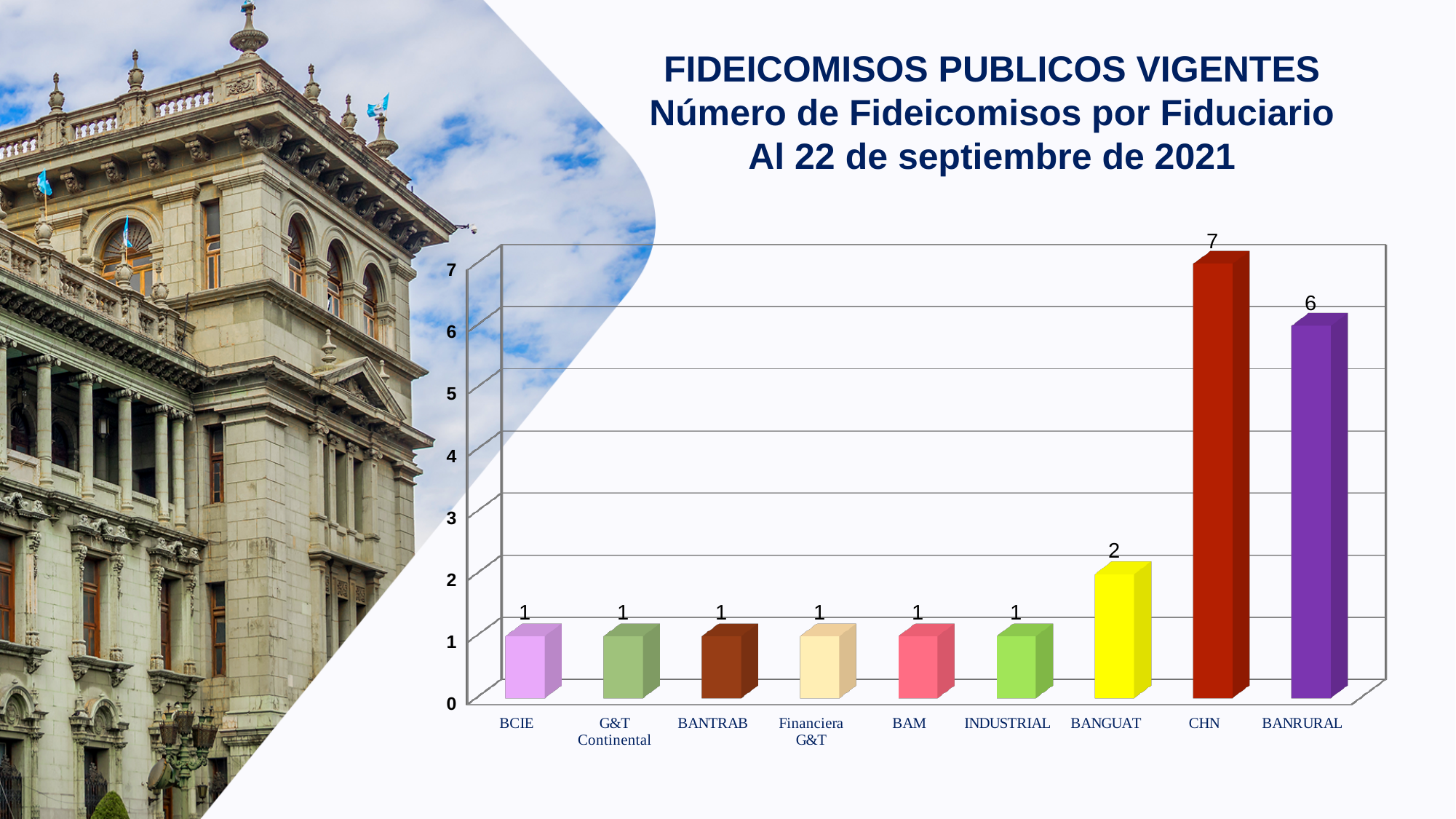
What is the value shown for BANRURAL? 6 What is the difference between the values for BANRURAL and BANGUAT? 4 What date does the chart title say the data is as of? 22 de septiembre de 2021 What kind of chart is shown on the slide? Bar chart How many fideicomisos does CHN have? 7 What is the difference between the values for CHN and BANRURAL? 1 What is the value shown for BANGUAT? 2 How many fiduciarios (categories) are shown on the x axis? 9 Which fiduciario has the highest number of fideicomisos? CHN Which is larger, the value for BANGUAT or the value for BAM? BANGUAT How many fiduciarios have a value of 1? 6 What is the total number of fideicomisos across all fiduciarios shown? 21